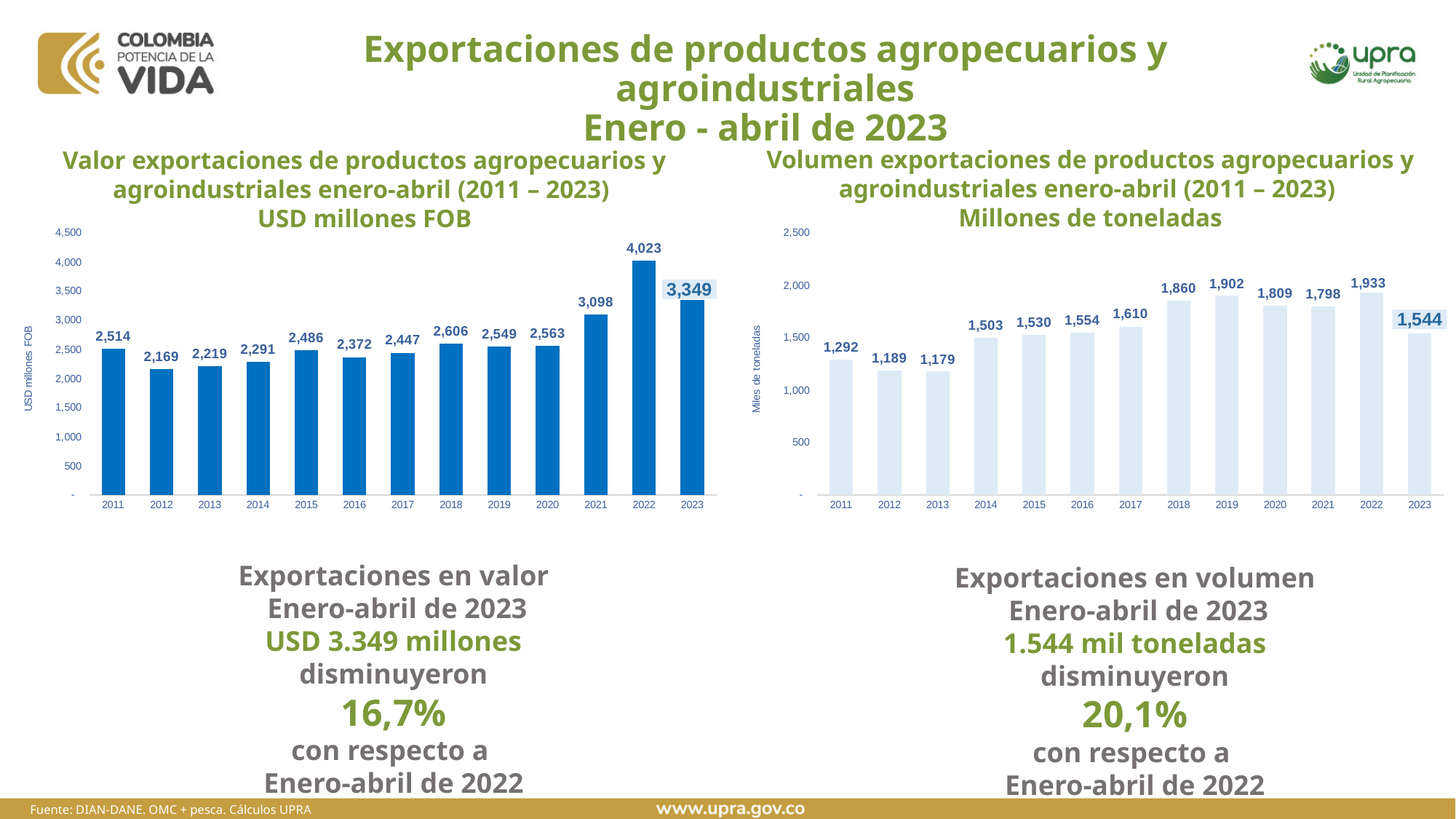
In the left chart (Valor exportaciones), what is the difference between the 2022 and 2023 values? 674 In the right chart (Volumen exportaciones), what is the value for 2019? 1,902 In the left chart (Valor exportaciones), what is the value for 2023? 3,349 In the right chart (Volumen exportaciones), which year has the highest value? 2022 In the right chart (Volumen exportaciones), is the value for 2018 larger than the value for 2020? Yes, 2018 (1,860) is larger than 2020 (1,809) What is the y-axis label of the right chart (Volumen exportaciones)? Miles de toneladas What type of chart is the left chart (Valor exportaciones)? Bar chart In the right chart (Volumen exportaciones), which year has the lowest value? 2013 In the left chart (Valor exportaciones), how many years are plotted? 13 In the right chart (Volumen exportaciones), what is the difference between the 2022 and 2023 values? 389 In the left chart (Valor exportaciones), which year has the lowest value? 2012 In the left chart (Valor exportaciones), what is the value for 2022? 4,023